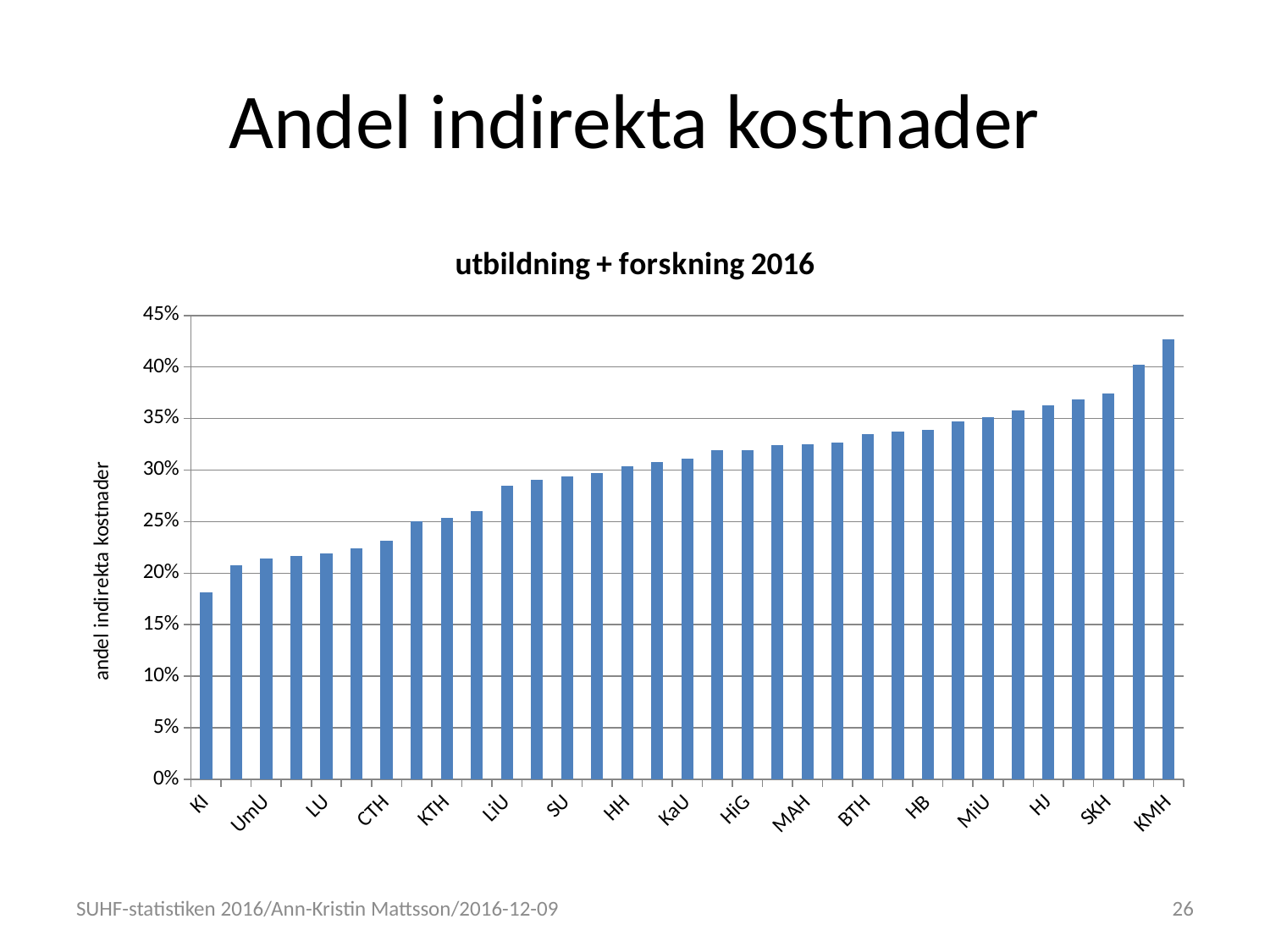
What is the title of the chart? utbildning + forskning 2016 Which category has the highest value? KMH What kind of chart is shown on the slide? bar chart Which has the larger value, SKH or LU? SKH Is the value for HJ greater or less than 35%? greater Which category has the lowest value? KI Is the value for KMH greater or less than 40%? greater Is the value for KI greater or less than 20%? less Do the values rise or fall from left to right along the x axis? rise What is the label of the vertical axis? andel indirekta kostnader